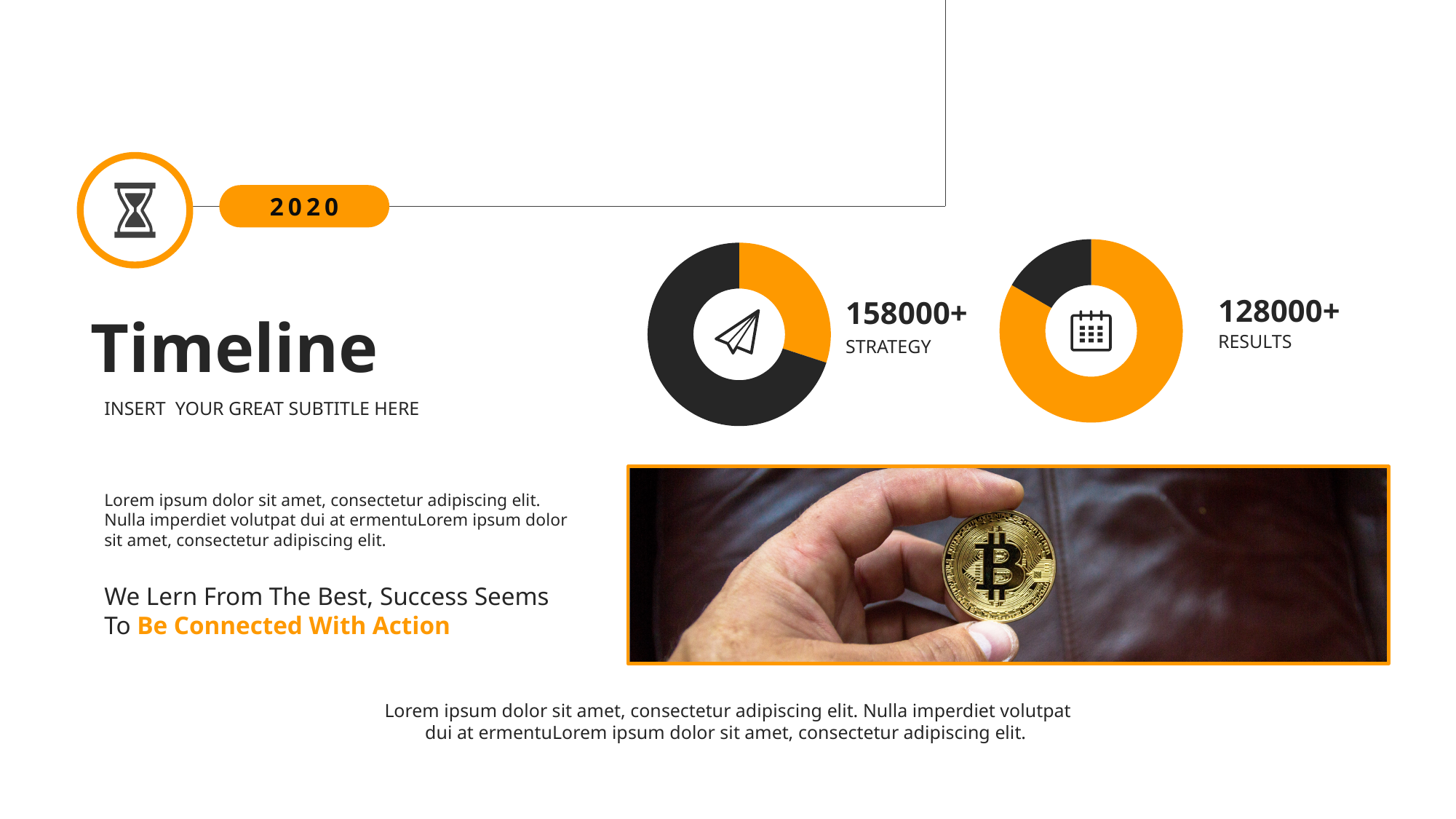
What value is printed next to the STRATEGY donut chart? 158000+ What value is printed next to the RESULTS donut chart? 128000+ What icon appears in the centre of the STRATEGY donut chart? A paper plane Which donut chart has the larger orange segment, STRATEGY or RESULTS? RESULTS In the STRATEGY donut chart, which colour covers the larger portion of the ring? Dark grey How many donut charts are on the slide? 2 How many segments does each donut chart have? 2 In the RESULTS donut chart, which colour covers the larger portion of the ring? Orange What kind of chart is shown next to the STRATEGY label? Donut chart What icon appears in the centre of the RESULTS donut chart? A calendar